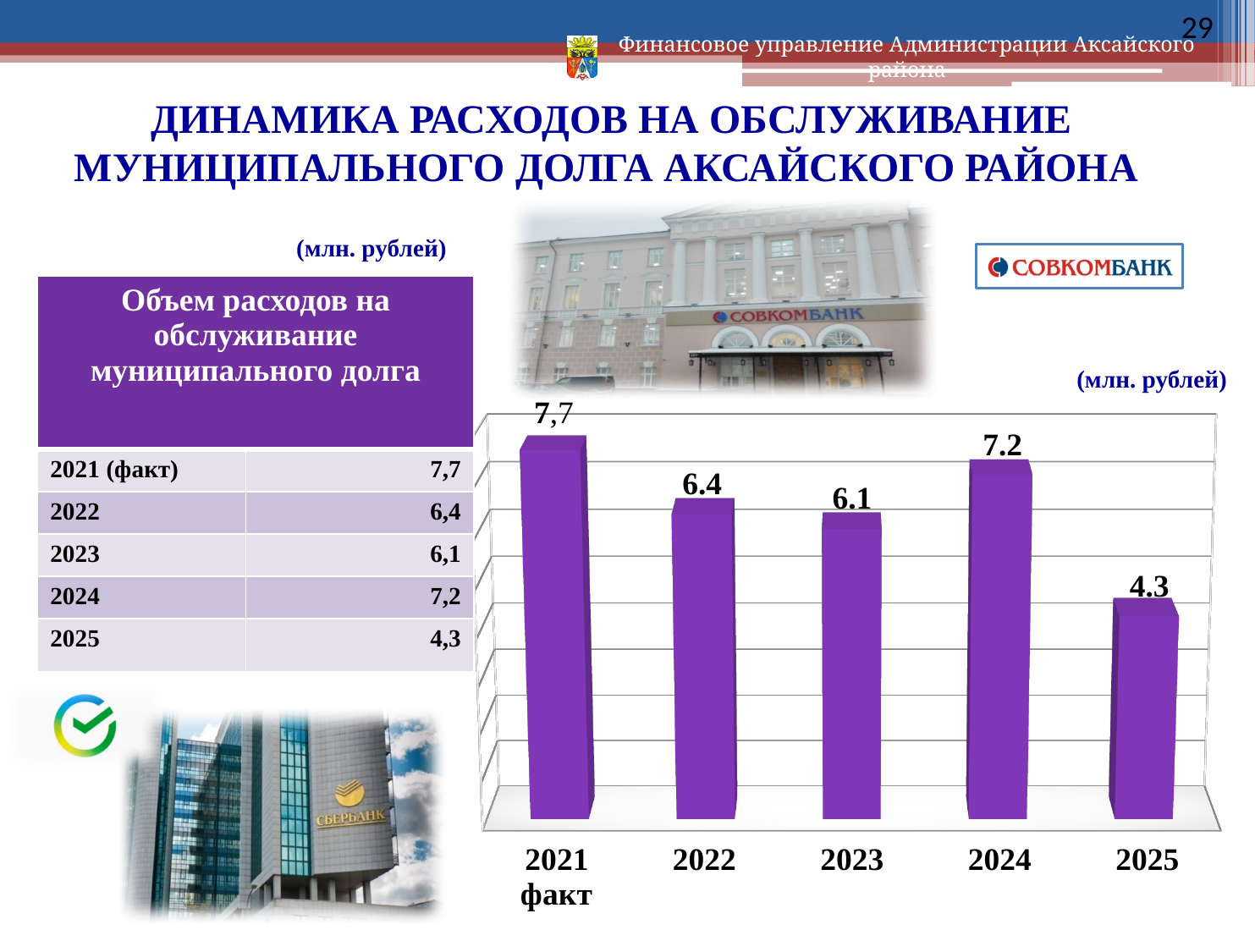
What unit is indicated for the values on the bar chart? млн. рублей Which is larger on the bar chart, the value for 2022 or the value for 2024? 2024 What is the value for 2022 on the bar chart? 6.4 Which year has the highest value on the bar chart? 2021 факт What is the value for 2025 on the bar chart? 4.3 What kind of chart is shown on the slide? bar chart Which year has the lowest value on the bar chart? 2025 How many bars are shown on the chart? 5 What is the value for 2024 on the bar chart? 7.2 What is the value for 2021 факт on the bar chart? 7,7 What is the difference between the values for 2024 and 2023 on the bar chart? 1.1 What is the difference between the values for 2021 факт and 2025 on the bar chart? 3.4